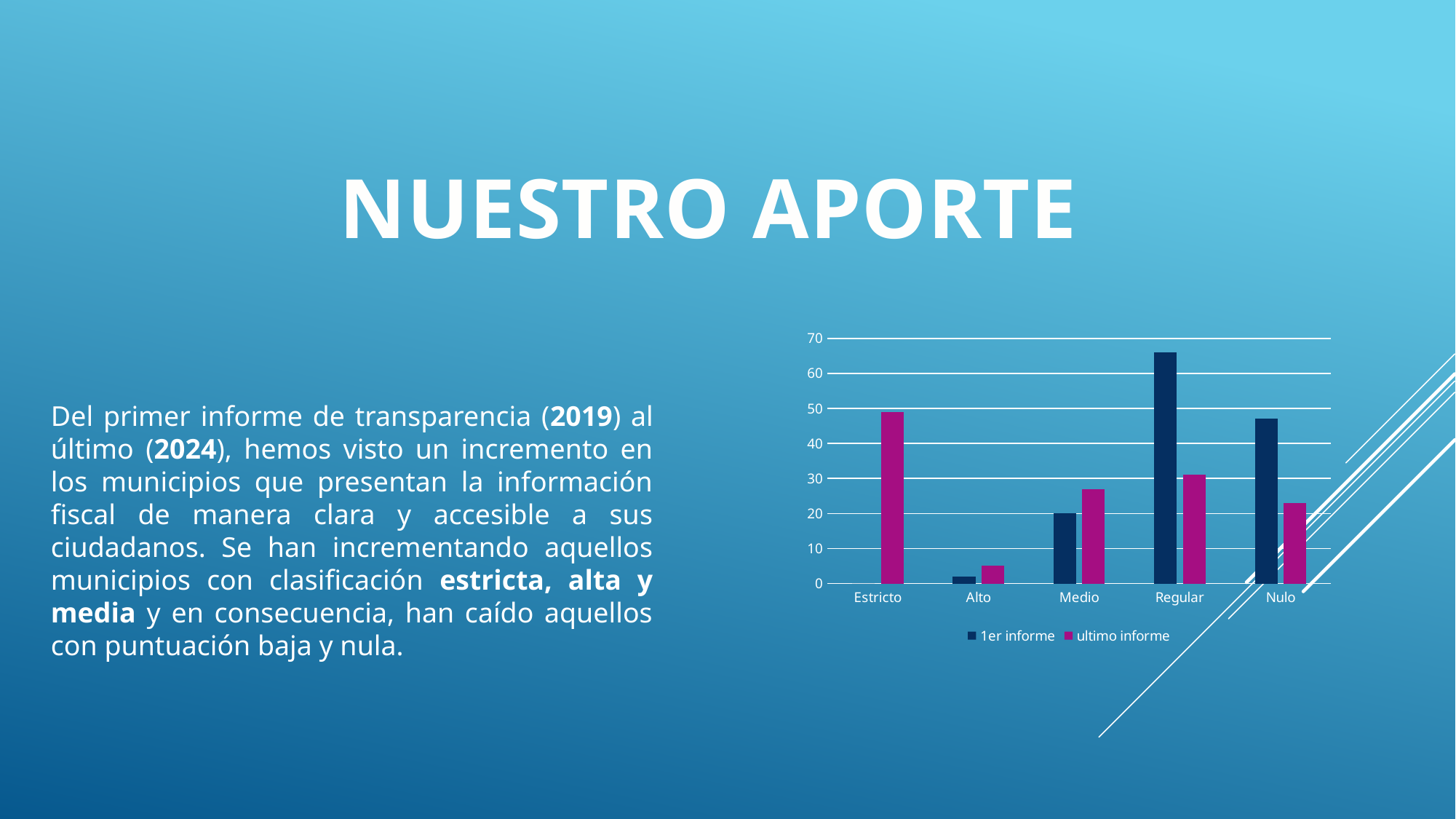
For the 'ultimo informe' series, which is larger, Estricto or Nulo? Estricto Is the 'ultimo informe' value for Estricto greater or less than 40? greater What are the two series names listed in the chart's legend? 1er informe and ultimo informe Which category has the highest value for the 'ultimo informe' series? Estricto For the Regular category, which series has the larger value, '1er informe' or 'ultimo informe'? 1er informe Is the '1er informe' value for Regular greater or less than 60? greater How many categories are shown on the x axis of the chart? 5 Which category has the highest value for the '1er informe' series? Regular How many series does the chart's legend list? 2 Which category has the lowest value for the 'ultimo informe' series? Alto Is the 'ultimo informe' value for Nulo greater or less than 30? less What kind of chart is shown on the slide? Bar chart